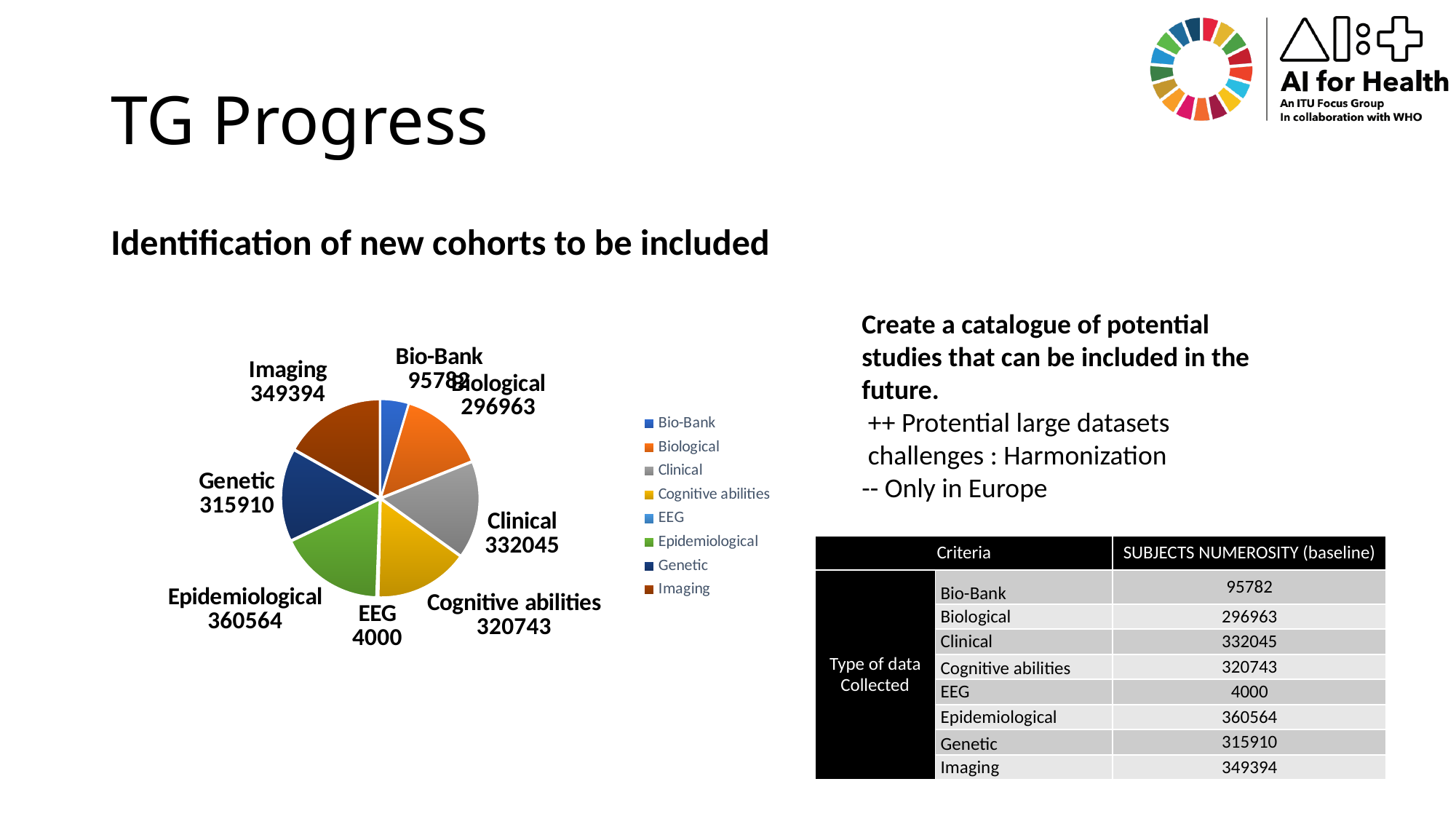
What value is shown for EEG in the pie chart? 4000 What is the difference between the Clinical and Biological values in the pie chart? 35082 Which category has the largest slice in the pie chart? Epidemiological What value is shown for Epidemiological in the pie chart? 360564 How many entries does the pie chart legend list? 8 Which category has the smallest slice in the pie chart? EEG What value is shown for Genetic in the pie chart? 315910 What kind of chart is shown on the slide? Pie chart What value is shown for Clinical in the pie chart? 332045 Which is larger in the pie chart, Cognitive abilities or Biological? Cognitive abilities How many categories are shown in the pie chart? 8 What is the difference between the Imaging and Genetic values in the pie chart? 33484